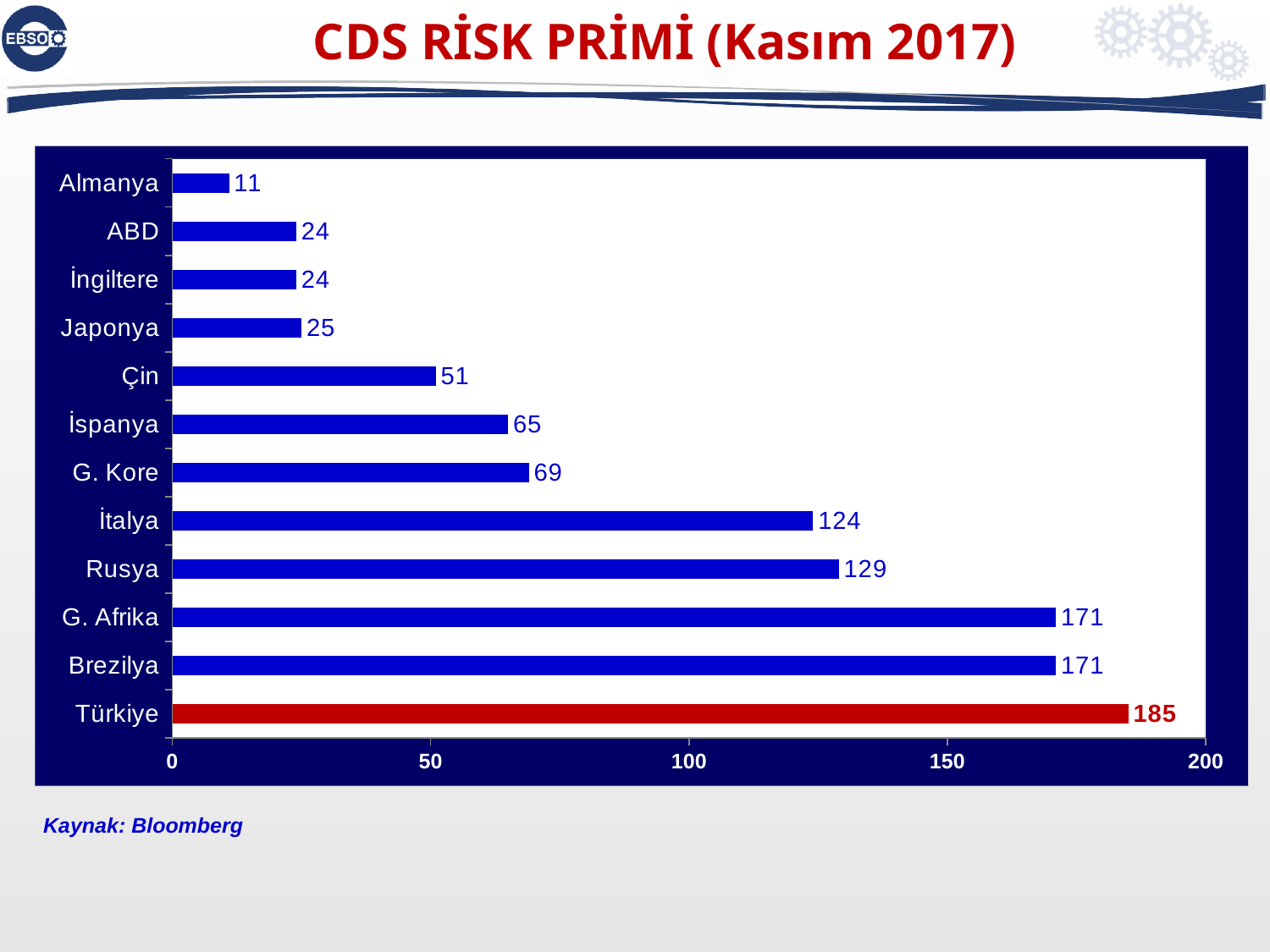
Which has a larger value, Rusya or İtalya? Rusya Which country has the highest CDS risk premium? Türkiye What is the CDS risk premium value for Türkiye? 185 Which country has the lowest CDS risk premium? Almanya How many countries are shown in the chart? 12 What kind of chart is shown on the slide? Bar chart What is the source cited below the chart? Bloomberg What is the value shown for Çin? 51 What is the difference between the values for Türkiye and Brezilya? 14 Is the value for G. Afrika greater or less than 150? greater What is the value shown for Rusya? 129 What is the difference between the values for İtalya and G. Kore? 55